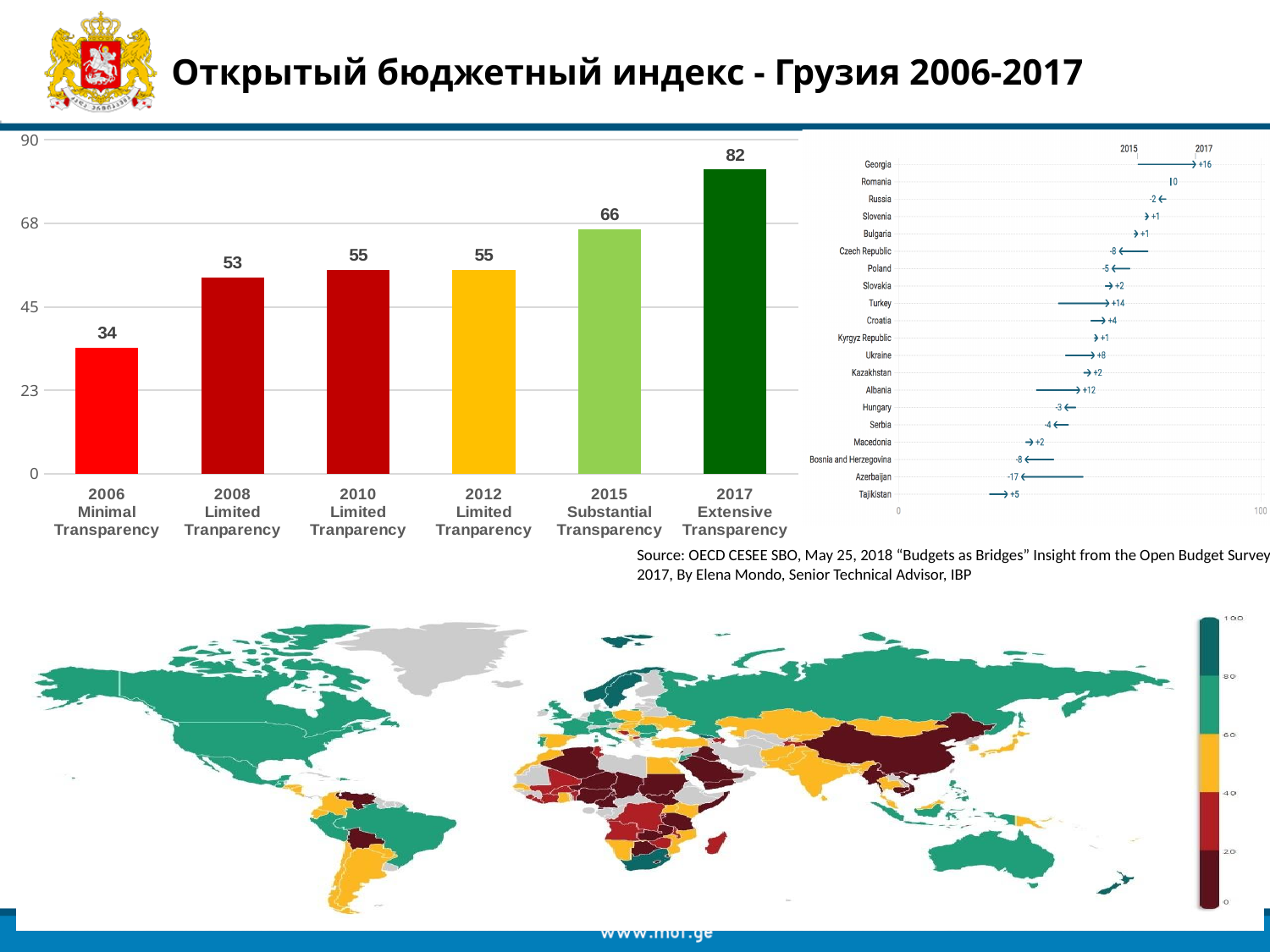
In the bar chart on the left, what is the difference between the values for 2015 and 2012? 11 In the bar chart on the left, do the values generally rise or fall from 2006 to 2017? rise In the bar chart on the left, what is the value for 2006? 34 In the bar chart on the left, what is the difference between the values for 2017 and 2006? 48 In the bar chart on the left, what is the value for 2015? 66 In the bar chart on the left, what is the value for 2017? 82 In the bar chart on the left, which is larger, the value for 2008 or the value for 2010? 2010 What kind of chart is shown on the left of the slide? bar chart In the bar chart on the left, which year has the highest value? 2017 In the bar chart on the left, which year has the lowest value? 2006 In the bar chart on the left, what transparency label is shown under the 2017 bar? Extensive Transparency In the bar chart on the left, how many bars are plotted? 6